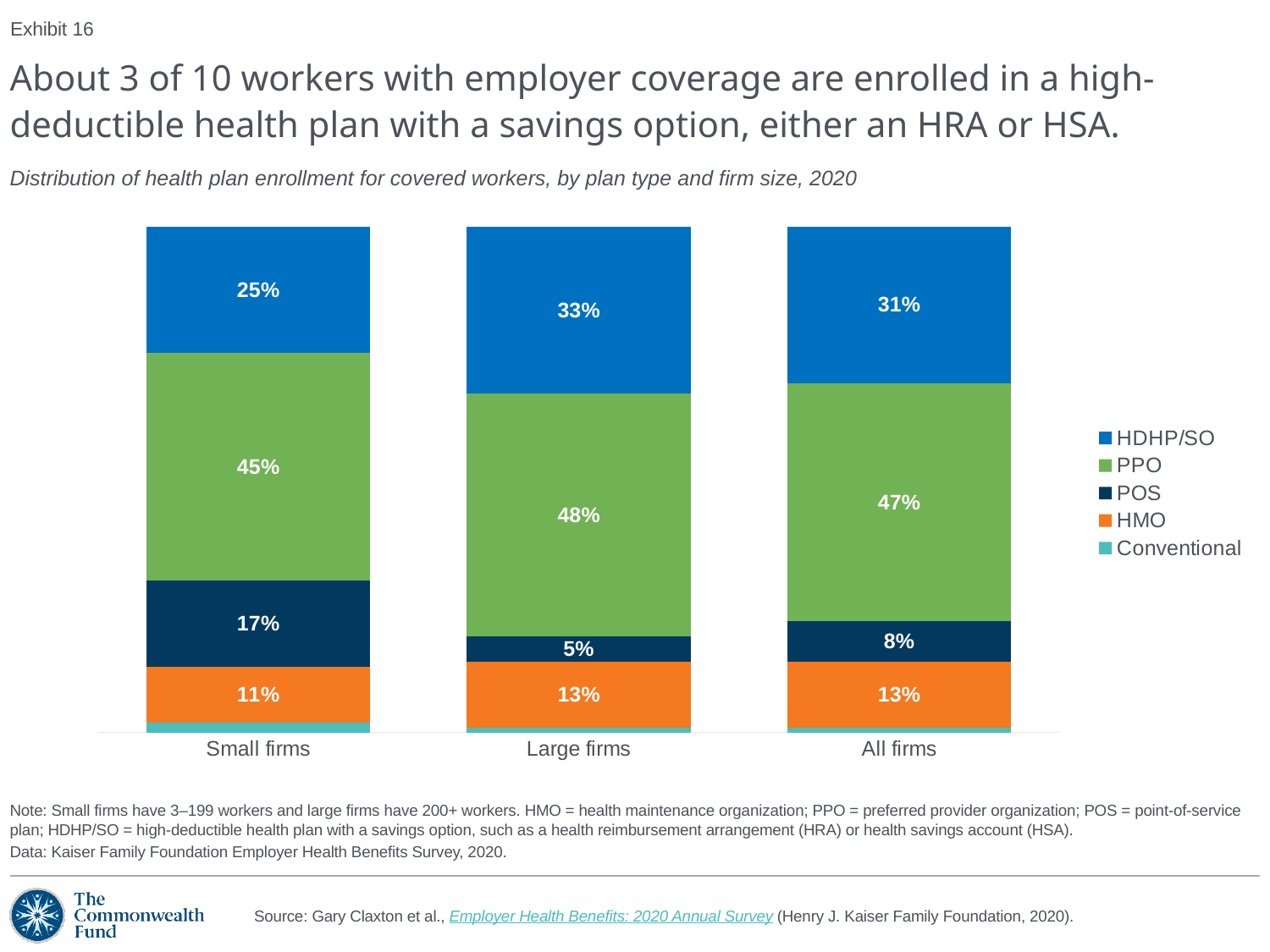
Which is larger: the PPO share for Small firms or the PPO share for All firms? All firms What is the PPO share for Large firms? 48% How many series does the legend list? 5 What is the HMO share for Large firms? 13% What kind of chart is shown on the slide? Stacked bar chart Which plan type is shown in green in the legend? PPO What is the difference between the POS share for Small firms and for Large firms? 12 percentage points What is the HDHP/SO share for Small firms? 25% How many firm size categories are shown on the x axis? 3 What is the POS share for All firms? 8% Which firm size category has the highest HDHP/SO share? Large firms Which firm size category has the lowest POS share? Large firms